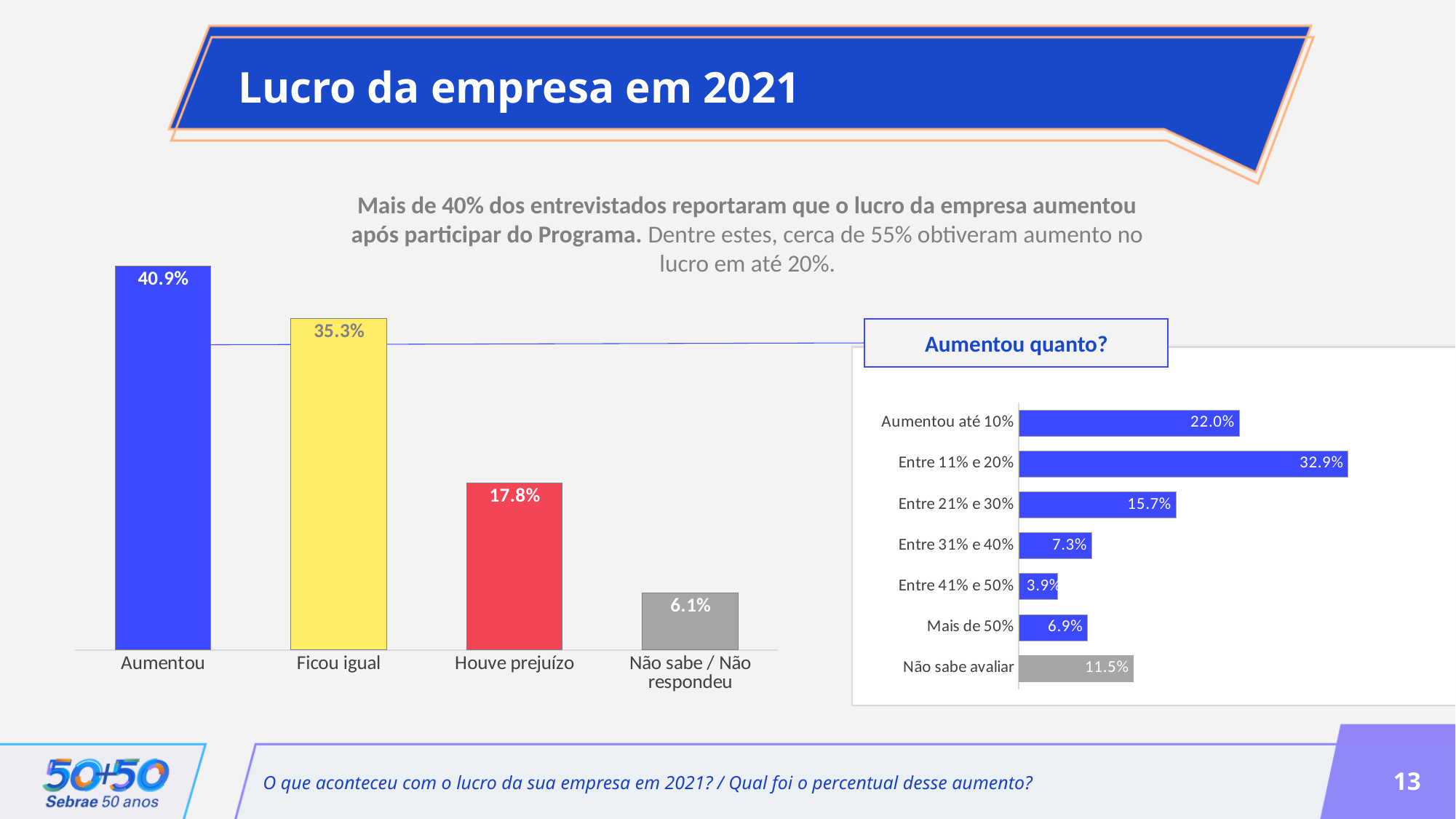
In the left bar chart, which category has the lowest value? Não sabe / Não respondeu In the "Aumentou quanto?" chart, which category has the highest value? Entre 11% e 20% In the "Aumentou quanto?" chart, what is the value for "Entre 11% e 20%"? 32.9% In the "Aumentou quanto?" chart, which category has the lowest value? Entre 41% e 50% In the left bar chart, what is the value for "Houve prejuízo"? 17.8% In the left bar chart, what is the difference between "Aumentou" and "Ficou igual"? 5.6% In the "Aumentou quanto?" chart, what is the value for "Não sabe avaliar"? 11.5% In the left bar chart, what is the value for "Aumentou"? 40.9% What kind of chart is the left chart? bar chart In the "Aumentou quanto?" chart, which is larger: "Entre 31% e 40%" or "Mais de 50%"? Entre 31% e 40% In the "Aumentou quanto?" chart, how many categories are shown? 7 In the left bar chart, how many categories are shown? 4